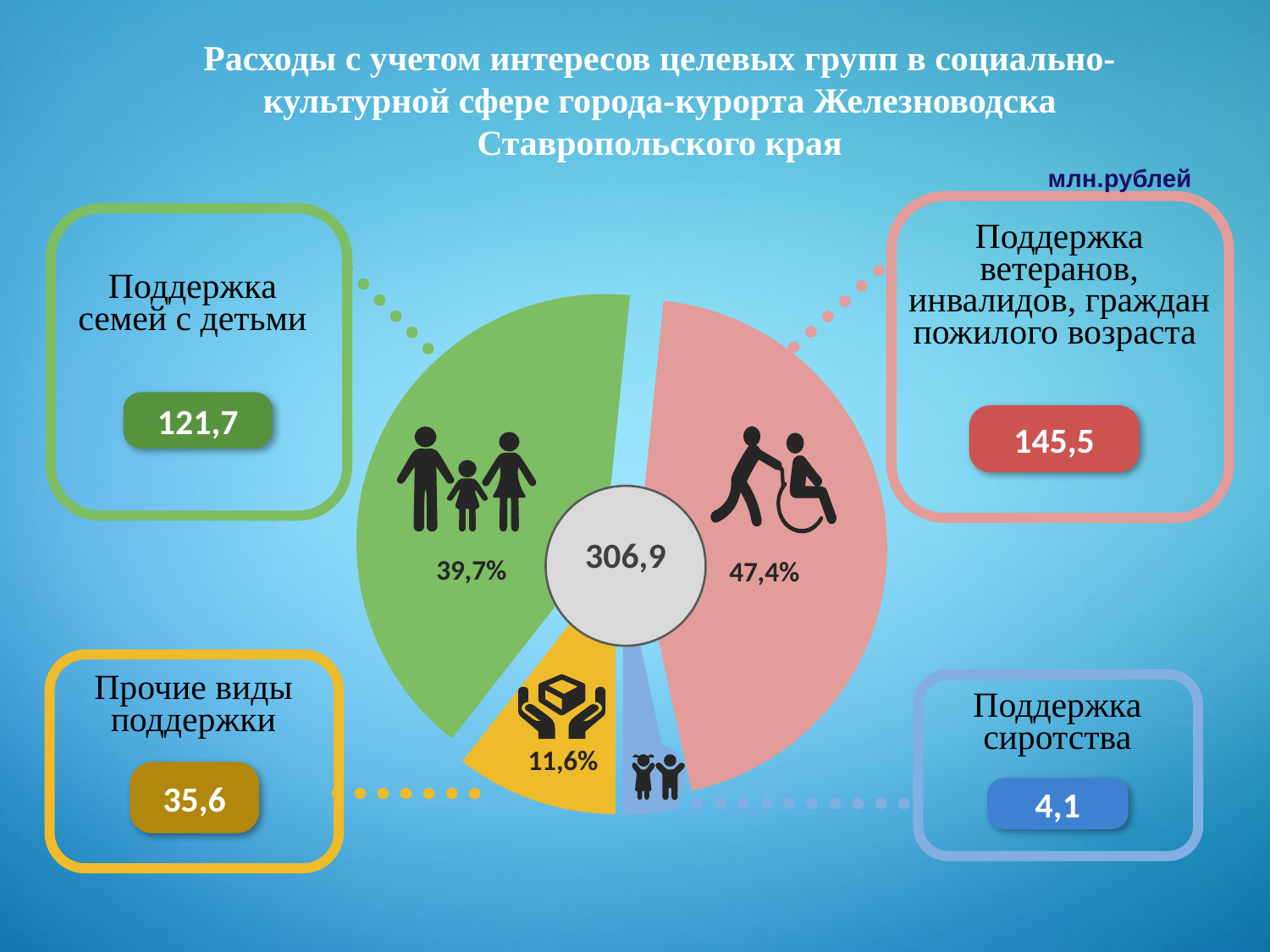
What is the value for "Прочие виды поддержки"? 35,6 What is the value for "Поддержка сиротства"? 4,1 What is the value for "Поддержка семей с детьми"? 121,7 What share of the pie does "Поддержка семей с детьми" represent? 39,7% What total value is shown in the centre of the pie chart? 306,9 Which category has the smallest slice of the pie? Поддержка сиротства How many slices does the pie chart have? 4 What share of the pie does "Поддержка ветеранов, инвалидов, граждан пожилого возраста" represent? 47,4% What share of the pie does "Прочие виды поддержки" represent? 11,6% What kind of chart is shown on the slide? pie chart What is the value for "Поддержка ветеранов, инвалидов, граждан пожилого возраста"? 145,5 Which category has the largest slice of the pie? Поддержка ветеранов, инвалидов, граждан пожилого возраста